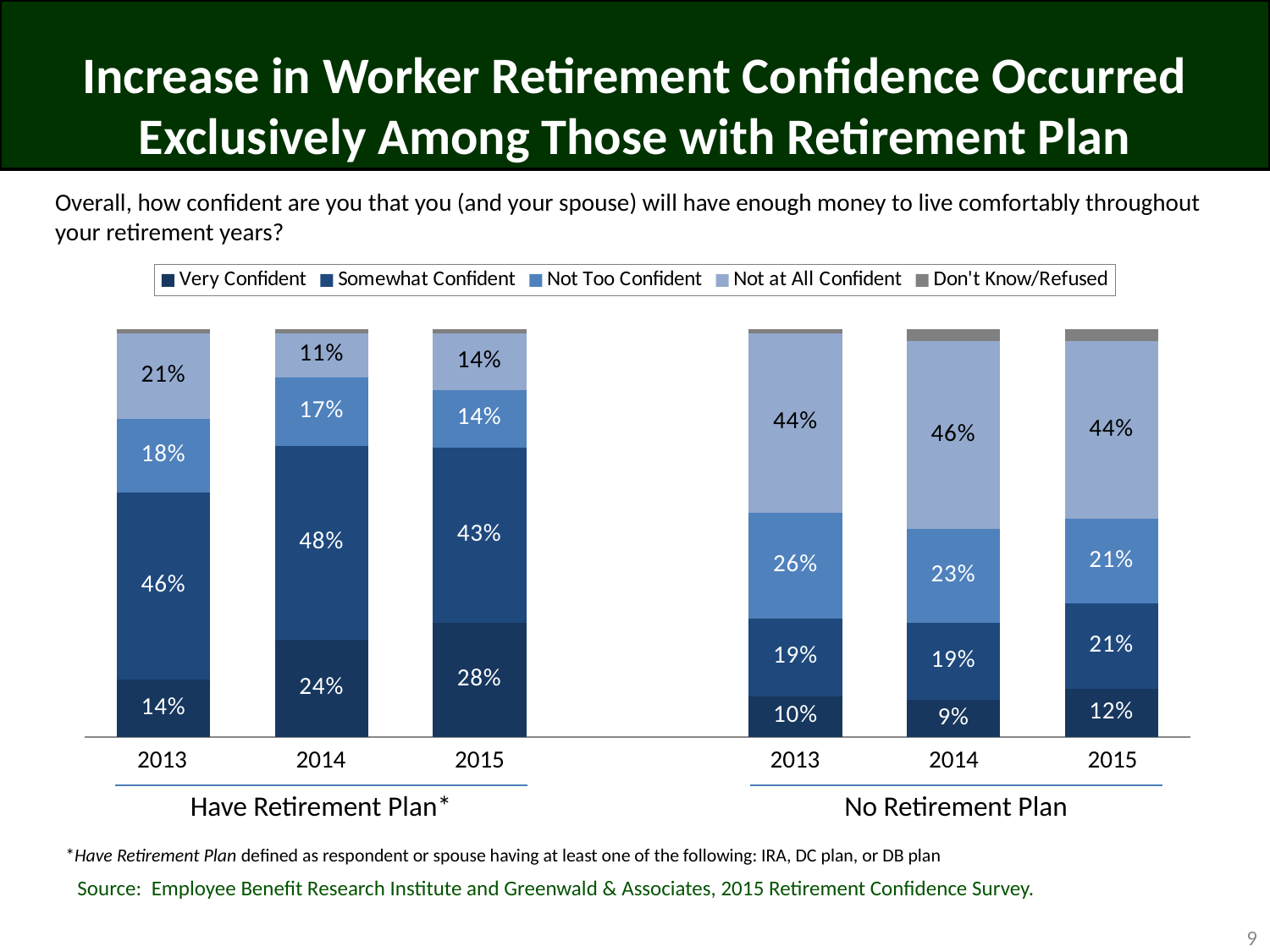
How many percentage points higher is the Very Confident share for workers with a retirement plan in 2015 than in 2013? 14 Among the Have Retirement Plan bars, which year has the highest Very Confident share? 2015 Which is larger: the Not at All Confident share for workers with a retirement plan in 2013 or for workers with no retirement plan in 2013? No Retirement Plan (44%) Does the Very Confident share for workers with a retirement plan rise or fall from 2013 to 2015? Rise What kind of chart is shown on the slide? Stacked bar chart Among the No Retirement Plan bars, which year has the lowest Very Confident share? 2014 What percentage of workers with a retirement plan were Somewhat Confident in 2014? 48% How many series does the legend list? 5 What percentage of workers with a retirement plan were Very Confident in 2015? 28% What percentage of workers with no retirement plan were Very Confident in 2013? 10% What percentage of workers with no retirement plan were Not at All Confident in 2014? 46% Which legend entry is shown in the darkest blue colour? Very Confident